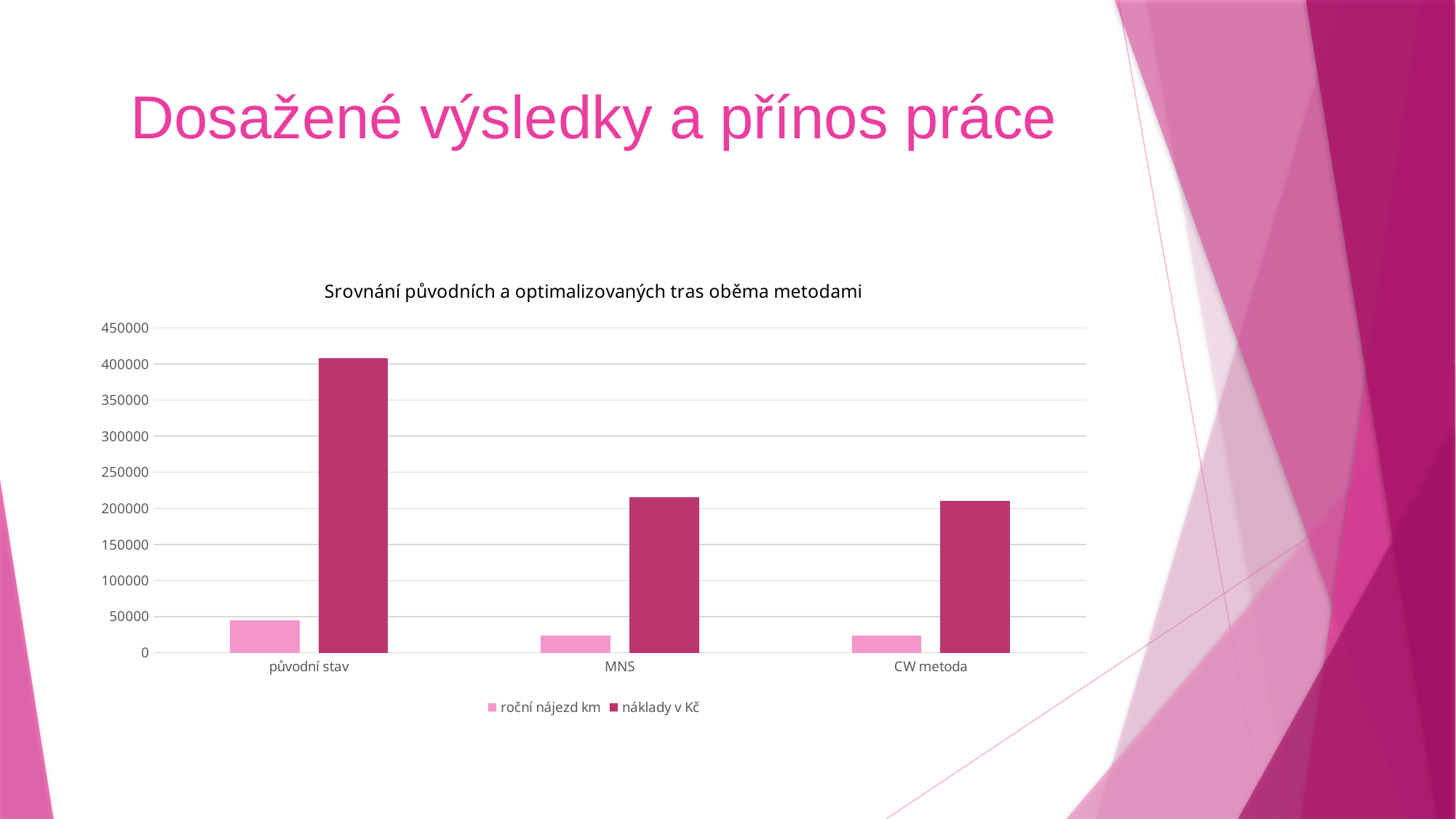
Is the value of náklady v Kč for CW metoda greater or less than 250000? less Which category has the highest value for náklady v Kč? původní stav Which is larger: náklady v Kč for původní stav or náklady v Kč for MNS? původní stav What kind of chart is shown on the slide? bar chart Do the náklady v Kč values rise or fall from původní stav to CW metoda along the x axis? fall How many series does the chart legend list? 2 Which category has the highest value for roční nájezd km? původní stav Is the value of náklady v Kč for MNS greater or less than 200000? greater Is the value of náklady v Kč for původní stav greater or less than 350000? greater What is the title of the chart? Srovnání původních a optimalizovaných tras oběma metodami How many categories are shown on the x axis of the chart? 3